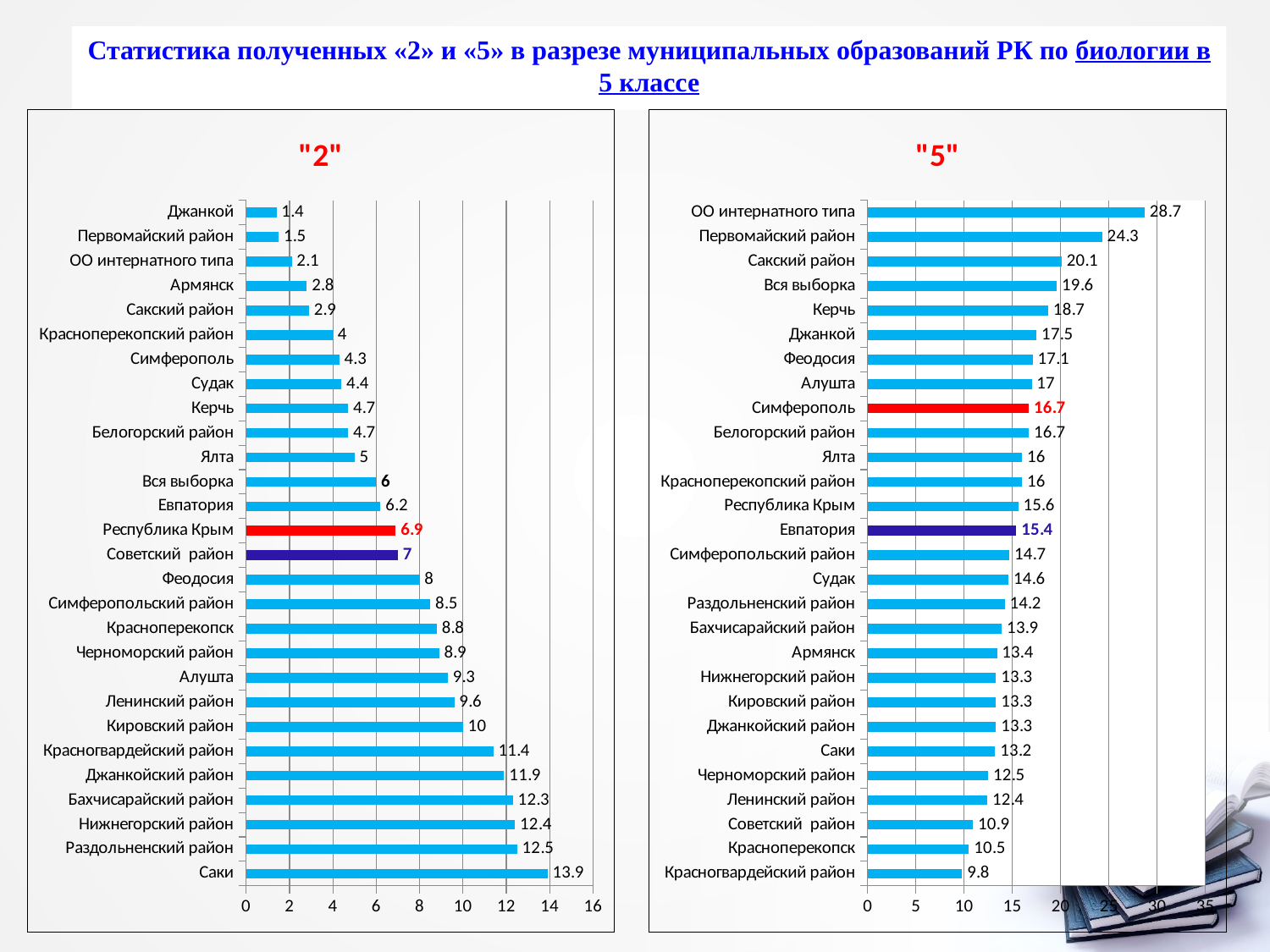
In the "5" chart, which category has the highest value? ОО интернатного типа What type of chart is the "2" chart? Bar chart In the "5" chart, what is the value for Евпатория? 15.4 In the "2" chart, which category has the lowest value? Джанкой How many categories are shown in the "5" chart? 28 In the "2" chart, what is the difference between the values for Саки and Джанкой? 12.5 In the "5" chart, what is the difference between the values for Первомайский район and Сакский район? 4.2 In the "2" chart, what is the value for Республика Крым? 6.9 In the "5" chart, which category has the lowest value? Красногвардейский район In the "5" chart, what is the value for ОО интернатного типа? 28.7 In the "2" chart, which is larger, the value for Феодосия or the value for Евпатория? Феодосия In the "2" chart, what is the value for Саки? 13.9